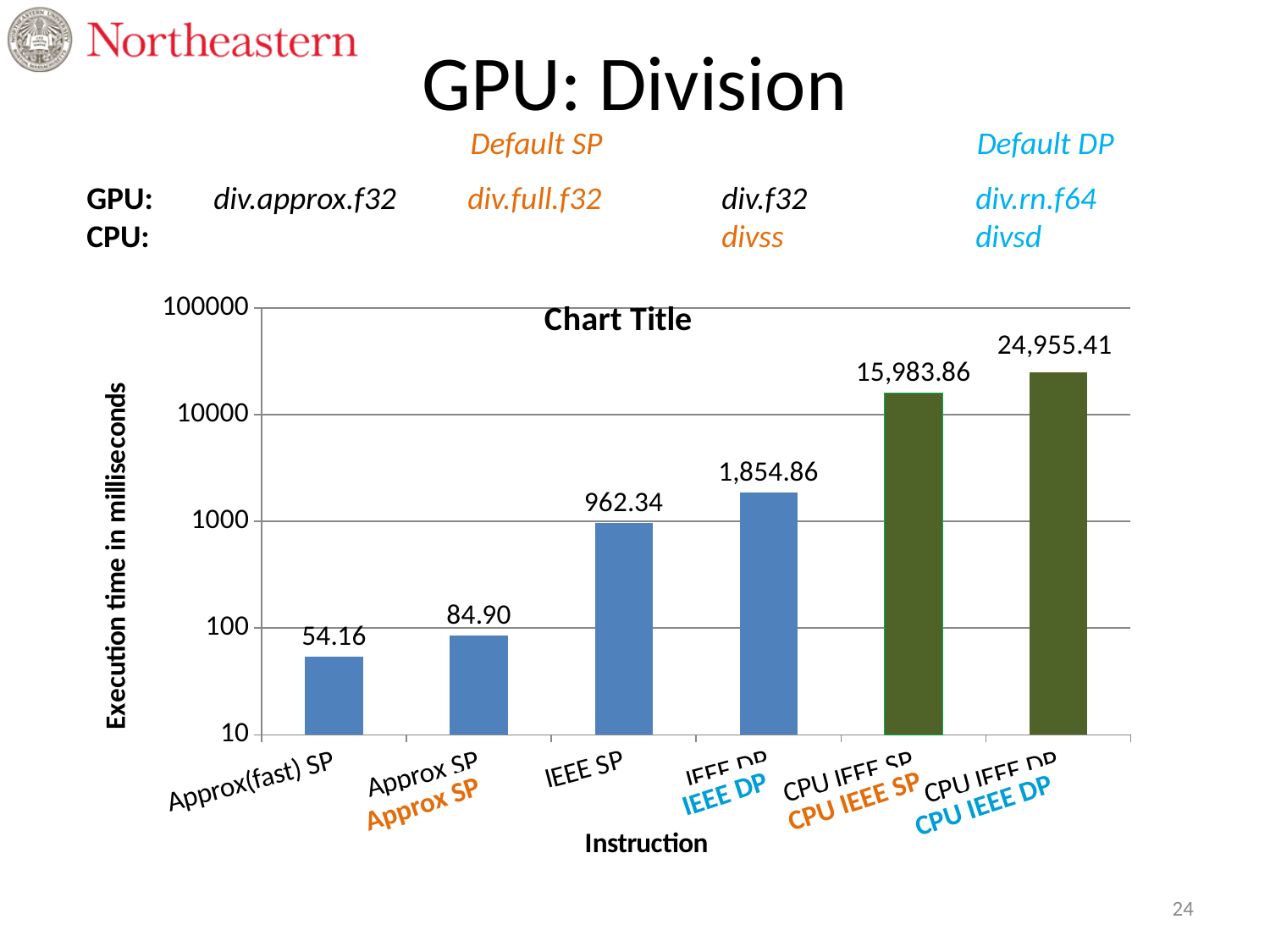
What is the execution time for CPU IEEE DP? 24,955.41 What is the execution time for Approx(fast) SP? 54.16 What is the label of the y axis of the chart? Execution time in milliseconds How many instructions are plotted on the chart? 6 Which has a larger execution time, IEEE DP or CPU IEEE SP? CPU IEEE SP Which instruction has the highest execution time? CPU IEEE DP Which instruction has the lowest execution time? Approx(fast) SP What is the execution time for IEEE SP? 962.34 What is the execution time for IEEE DP? 1,854.86 Do the execution times rise or fall from left to right along the x axis? Rise What kind of chart is shown on the slide? Bar chart What is the difference in execution time between Approx SP and Approx(fast) SP? 30.74